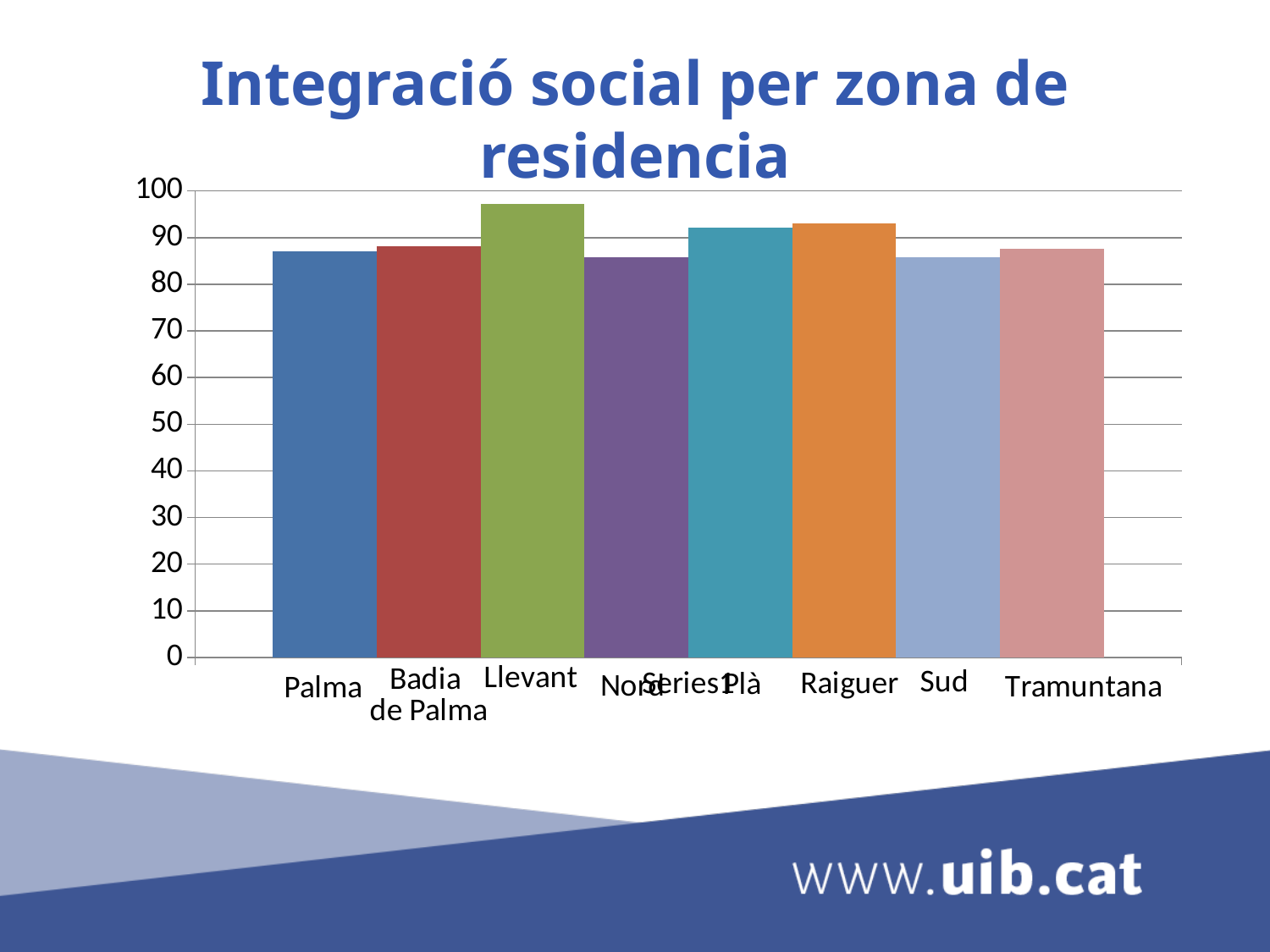
Which zone has the highest value? Llevant Is the value for Palma greater or less than 90? less Is the value for Raiguer greater or less than 90? greater What is the maximum value shown on the y axis? 100 Is the value for Llevant greater or less than 90? greater What is the title of the chart? Integració social per zona de residencia How many zones (categories) are shown on the x axis? 8 Which has a larger value, Raiguer or Sud? Raiguer Which has a larger value, Llevant or Palma? Llevant What kind of chart is shown on the slide? bar chart